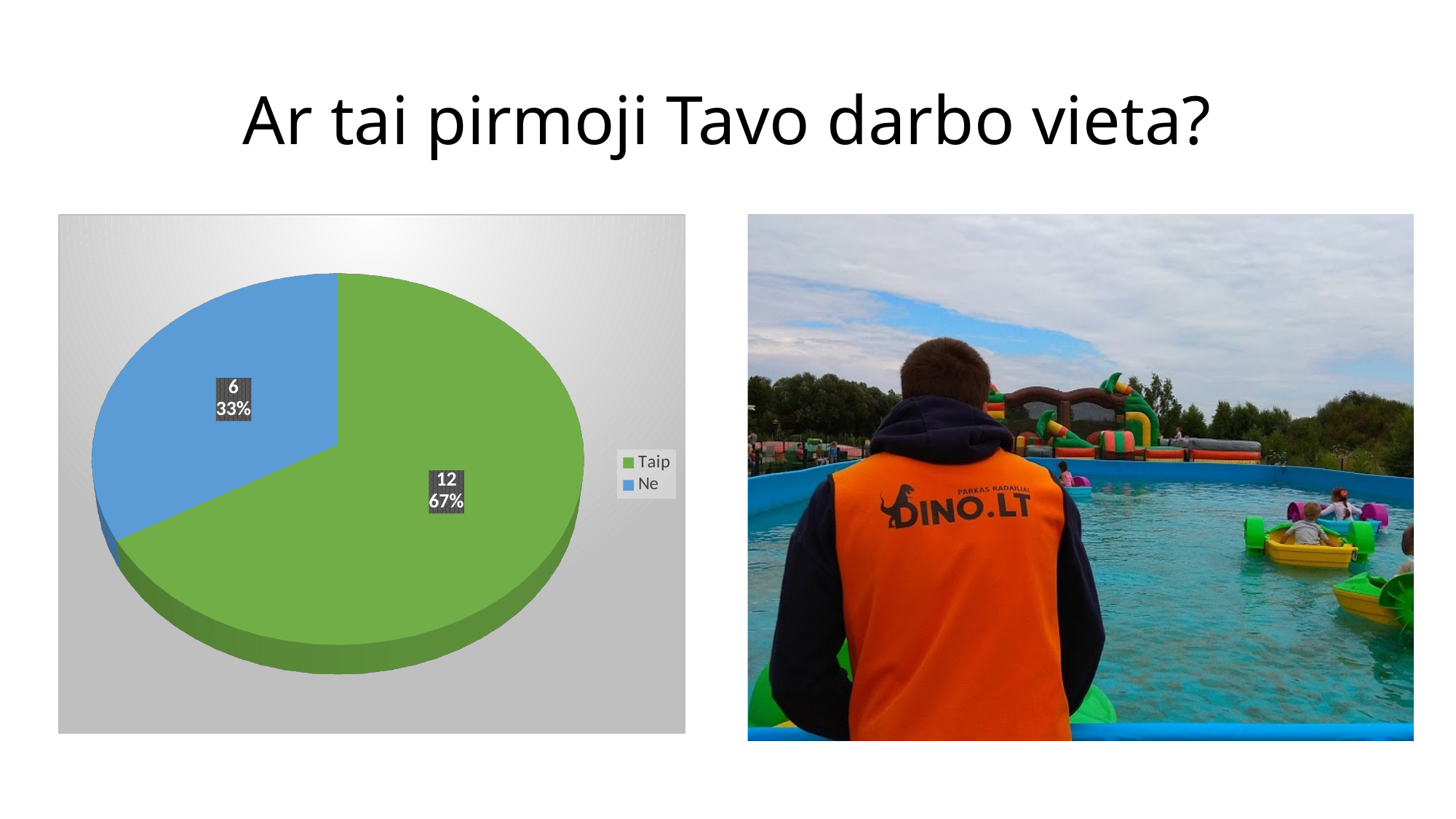
Which is larger, the value for "Taip" or the value for "Ne"? Taip Which category has the largest slice of the pie? Taip How many respondents answered "Ne"? 6 What is the difference between the counts for "Taip" and "Ne"? 6 What percentage of the pie does the "Taip" slice represent? 67% What is the total of the two values shown in the pie chart? 18 How many categories does the pie chart have? 2 What colour is the "Ne" slice in the pie chart? blue What percentage of the pie does the "Ne" slice represent? 33% What kind of chart is shown on the slide? pie chart Which category has the smallest slice of the pie? Ne How many respondents answered "Taip"? 12